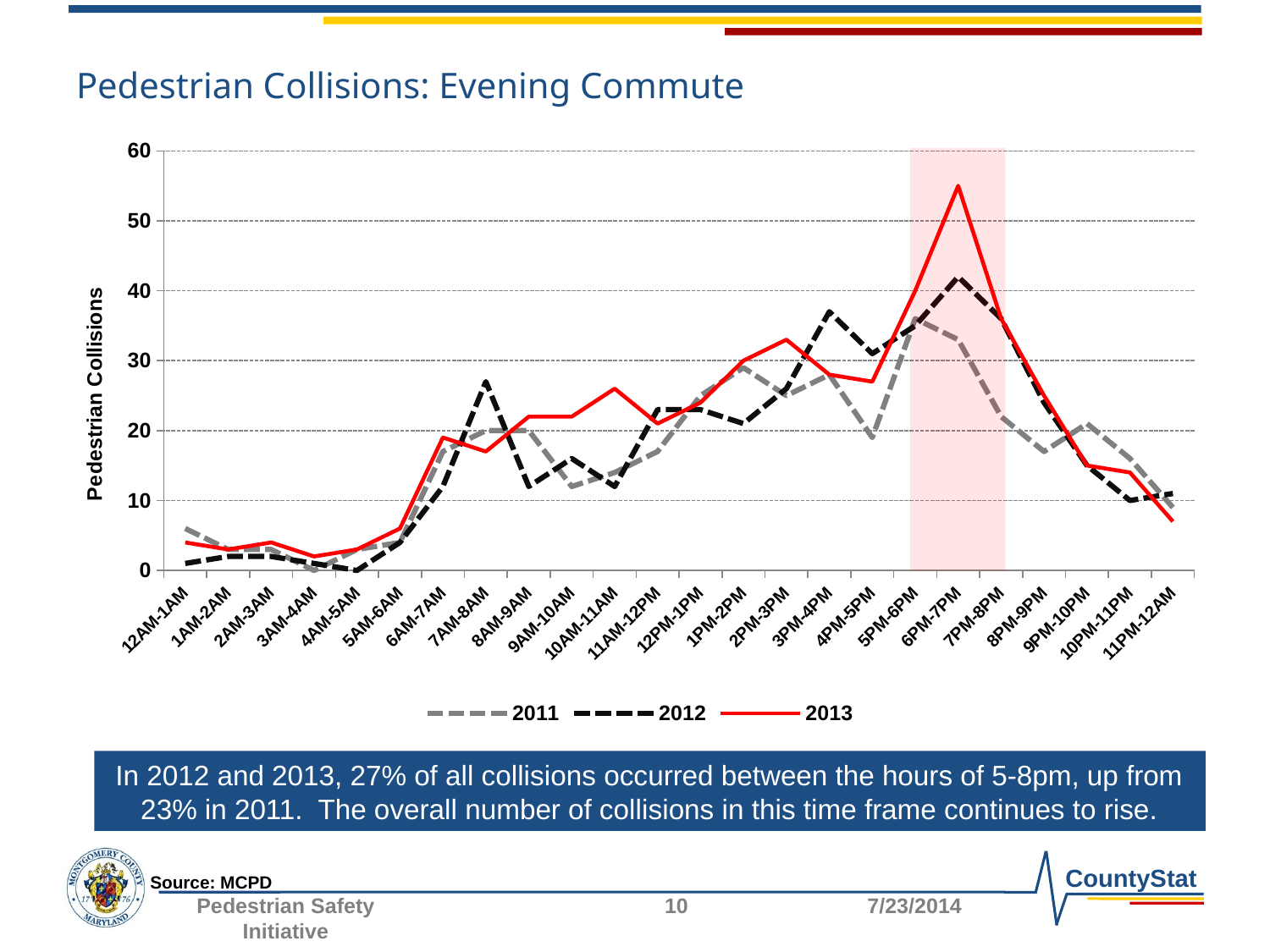
Is the 2013 value for 6PM-7PM greater or less than 50? greater Is the 2012 value for 3PM-4PM greater or less than 30? greater Is the 2013 value for 4AM-5AM greater or less than 10? less At 7AM-8AM, which series has the larger value, 2012 or 2013? 2012 How many series does the legend list? 3 What kind of chart is shown on the slide? Line chart In which time period does the 2013 line reach its highest value? 6PM-7PM Does the 2013 line rise or fall from 6PM-7PM to 11PM-12AM? Fall In which time period does the 2012 line reach its highest value? 6PM-7PM What is the label on the y axis? Pedestrian Collisions How many hourly time periods are shown along the x axis? 24